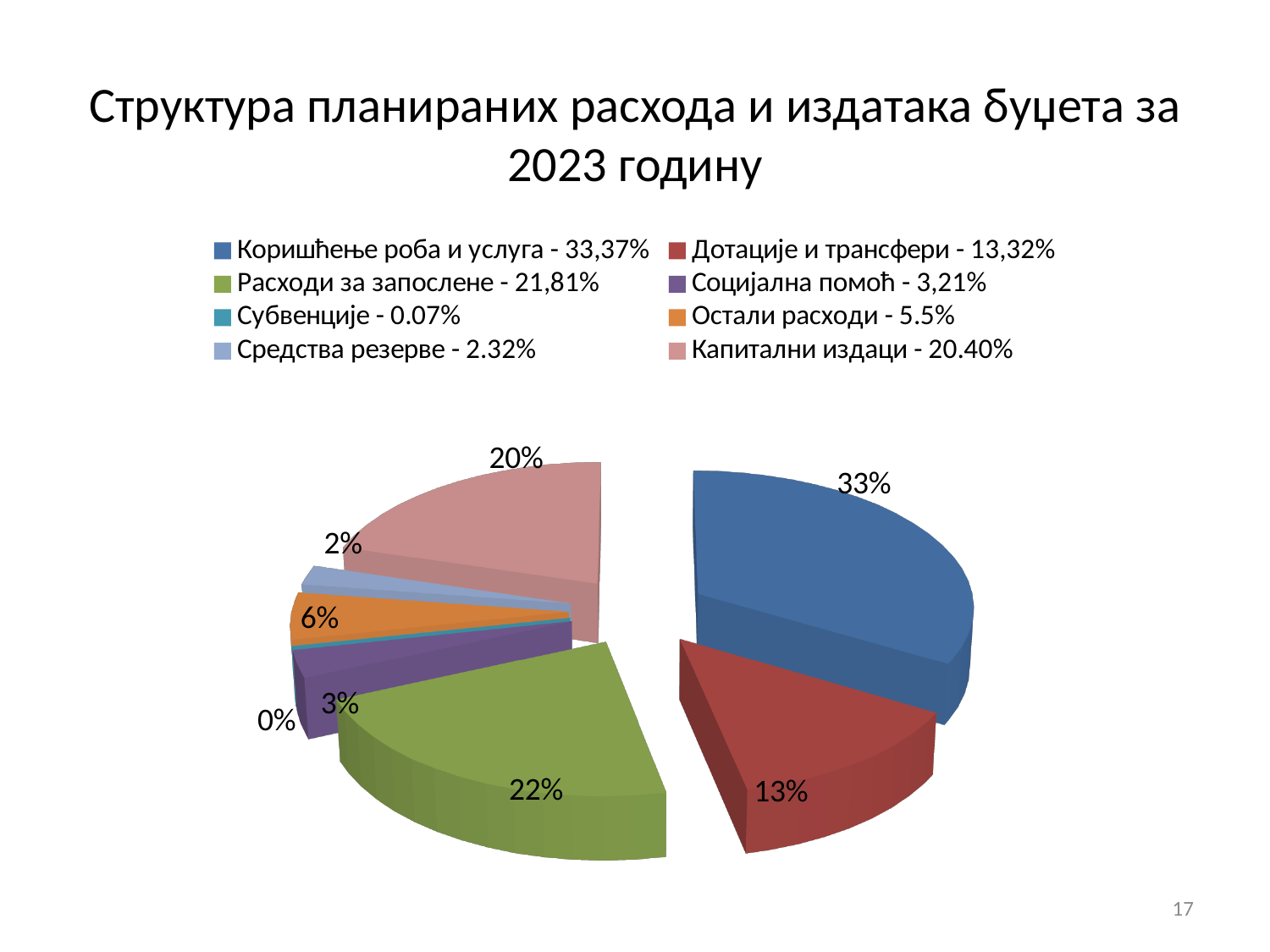
What kind of chart is shown on the slide? pie chart How many slices does the pie chart have? 8 Which slice is larger: Остали расходи or Средства резерве? Остали расходи Using the labels on the pie slices, what is the difference between the share for Коришћење роба и услуга and the share for Дотације и трансфери? 20 percentage points What percentage label is shown on the pie slice for Остали расходи? 6% What percentage does the legend give for Социјална помоћ? 3,21% Which category has the smallest share of the pie? Субвенције Which slice is larger: Дотације и трансфери or Капитални издаци? Капитални издаци What percentage does the legend give for Капитални издаци? 20.40% What percentage label is shown on the pie slice for Расходи за запослене? 22% Which category has the largest share of the pie? Коришћење роба и услуга What is the title of the chart slide? Структура планираних расхода и издатака буџета за 2023 годину